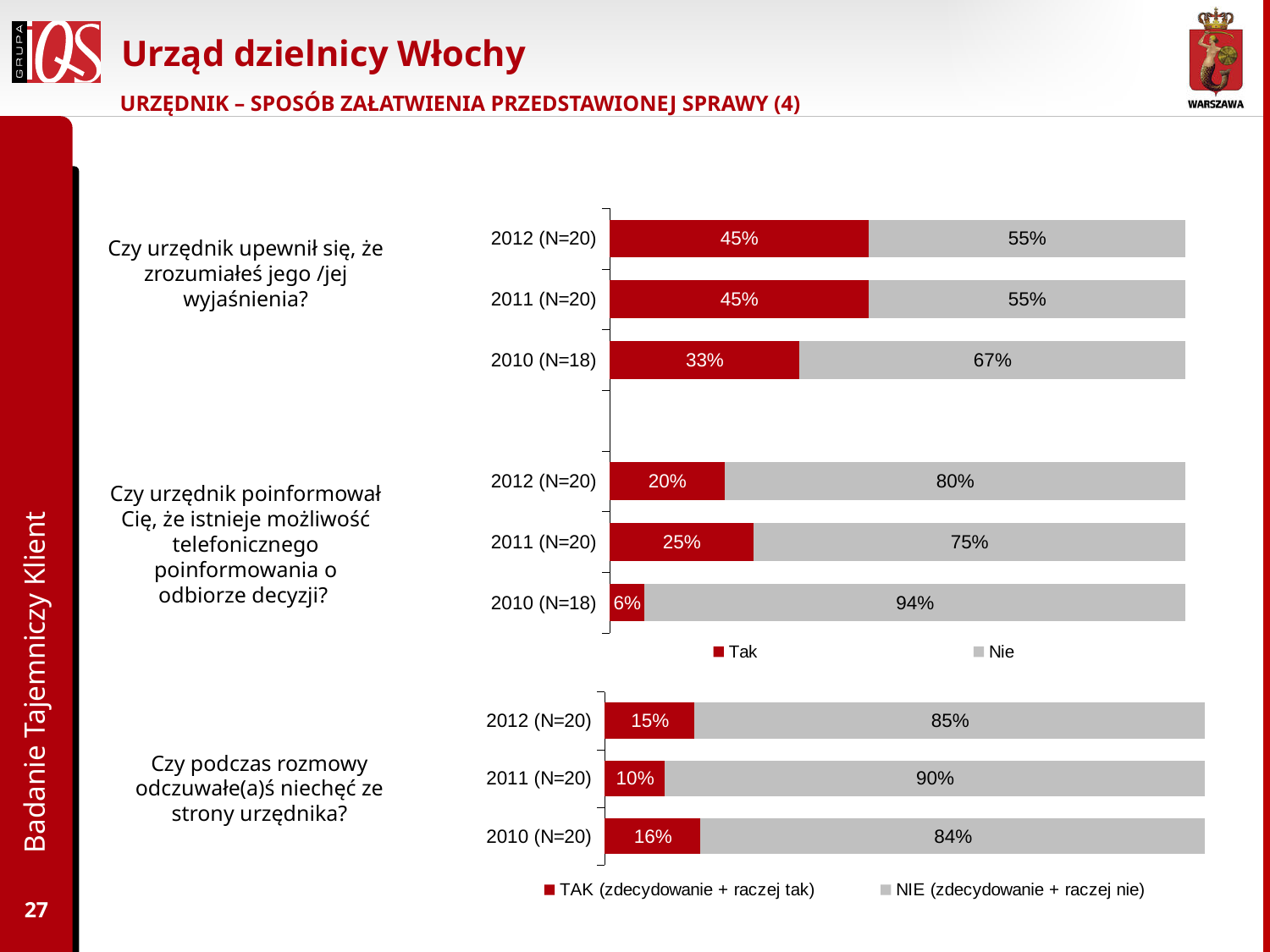
In the chart for "Czy podczas rozmowy odczuwałe(a)ś niechęć ze strony urzędnika?", which year has the highest NIE value? 2011 (N=20) In the chart for "Czy urzędnik upewnił się, że zrozumiałeś jego/jej wyjaśnienia?", what is the Nie value for 2012 (N=20)? 55% In the chart for "Czy urzędnik poinformował Cię, że istnieje możliwość telefonicznego poinformowania o odbiorze decyzji?", which year has the lowest Tak value? 2010 (N=18) How many series does the legend of the bottom chart ("Czy podczas rozmowy odczuwałe(a)ś niechęć ze strony urzędnika?") list? 2 In the chart for "Czy urzędnik upewnił się, że zrozumiałeś jego/jej wyjaśnienia?", what is the Tak value for 2010 (N=18)? 33% In the chart for "Czy podczas rozmowy odczuwałe(a)ś niechęć ze strony urzędnika?", what is the total of the 2011 (N=20) bar? 100% In the chart for "Czy podczas rozmowy odczuwałe(a)ś niechęć ze strony urzędnika?", what is the TAK value for 2012 (N=20)? 15% What type of chart is used on this slide? Stacked bar chart In the chart for "Czy urzędnik poinformował Cię, że istnieje możliwość telefonicznego poinformowania o odbiorze decyzji?", what is the Tak value for 2011 (N=20)? 25% In the chart for "Czy urzędnik poinformował Cię, że istnieje możliwość telefonicznego poinformowania o odbiorze decyzji?", what is the difference between the Nie values for 2010 (N=18) and 2012 (N=20)? 14% In the chart for "Czy podczas rozmowy odczuwałe(a)ś niechęć ze strony urzędnika?", is the TAK value for 2010 (N=20) larger or smaller than the TAK value for 2012 (N=20)? larger In the chart for "Czy urzędnik upewnił się, że zrozumiałeś jego/jej wyjaśnienia?", which year has the highest Nie value? 2010 (N=18)